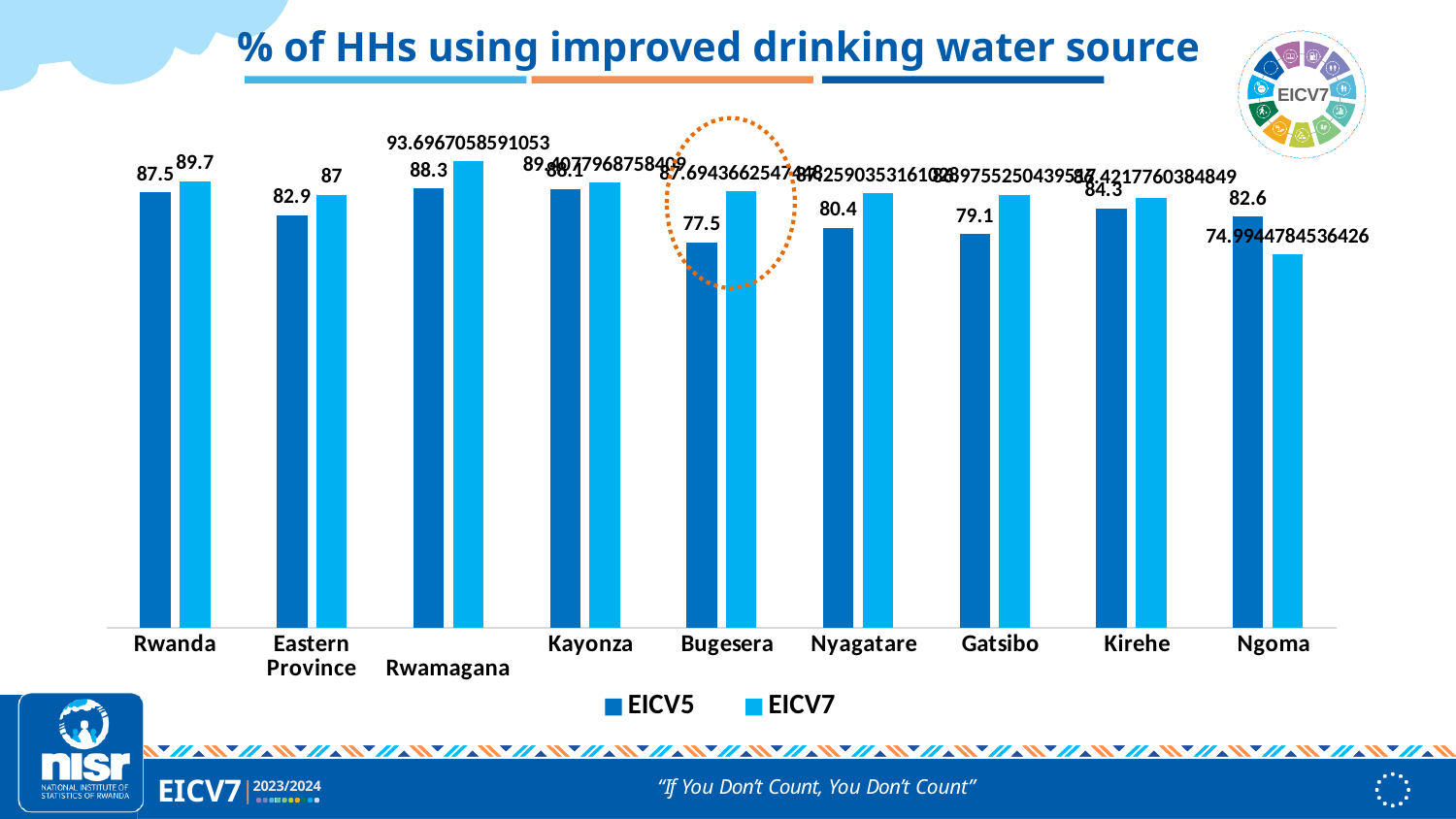
How many series does the legend list? 2 For Ngoma, which series has the larger value, EICV5 or EICV7? EICV5 How many categories are shown on the x axis? 9 What is the EICV7 value for Ngoma? 74.9944784536426 Which category has the lowest EICV7 value? Ngoma What is the EICV5 value for Bugesera? 77.5 What is the difference between the EICV7 and EICV5 values for Rwanda? 2.2 What is the difference between the EICV7 and EICV5 values for Eastern Province? 4.1 Which category has the highest EICV7 value? Rwamagana What is the EICV5 value for Gatsibo? 79.1 What is the EICV7 value for Rwamagana? 93.6967058591053 Which category has the lowest EICV5 value? Bugesera